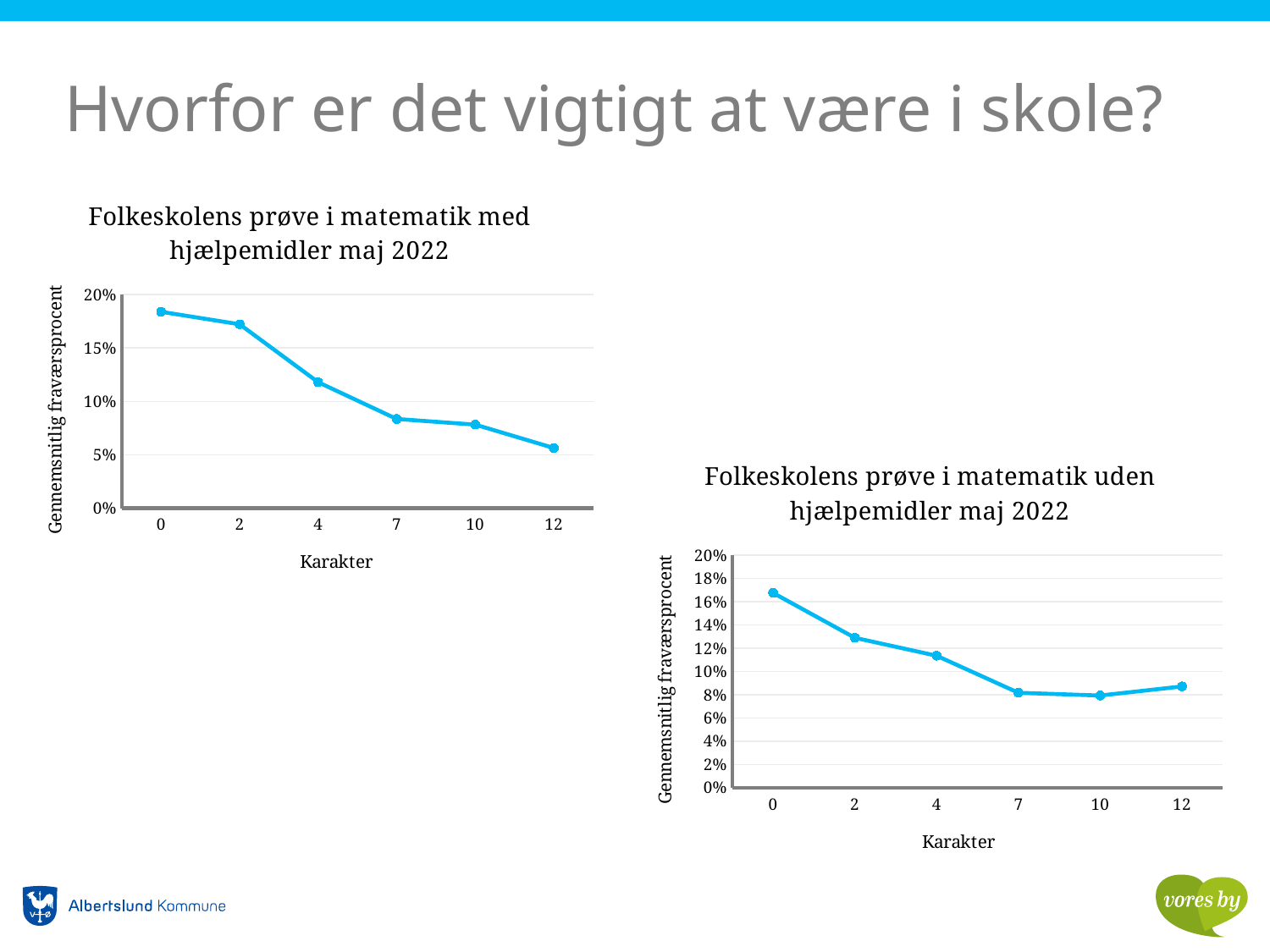
In the chart 'Folkeskolens prøve i matematik med hjælpemidler maj 2022', is the value for Karakter 12 greater or less than 10%? less In the chart 'Folkeskolens prøve i matematik med hjælpemidler maj 2022', how many data points are plotted? 6 In the chart 'Folkeskolens prøve i matematik uden hjælpemidler maj 2022', how many data points are plotted? 6 In the chart 'Folkeskolens prøve i matematik med hjælpemidler maj 2022', which Karakter has the lowest average absence percentage? 12 In the chart 'Folkeskolens prøve i matematik uden hjælpemidler maj 2022', which is larger, the value for Karakter 0 or for Karakter 12? Karakter 0 In the chart 'Folkeskolens prøve i matematik uden hjælpemidler maj 2022', is the value for Karakter 2 greater or less than 10%? greater What kind of chart is 'Folkeskolens prøve i matematik med hjælpemidler maj 2022'? Line chart What is the x-axis label on the chart 'Folkeskolens prøve i matematik uden hjælpemidler maj 2022'? Karakter In the chart 'Folkeskolens prøve i matematik med hjælpemidler maj 2022', do the values rise or fall as Karakter increases? Fall In the chart 'Folkeskolens prøve i matematik med hjælpemidler maj 2022', which Karakter has the highest average absence percentage? 0 In the chart 'Folkeskolens prøve i matematik med hjælpemidler maj 2022', is the value for Karakter 0 greater or less than 15%? greater In the chart 'Folkeskolens prøve i matematik uden hjælpemidler maj 2022', which Karakter has the highest average absence percentage? 0